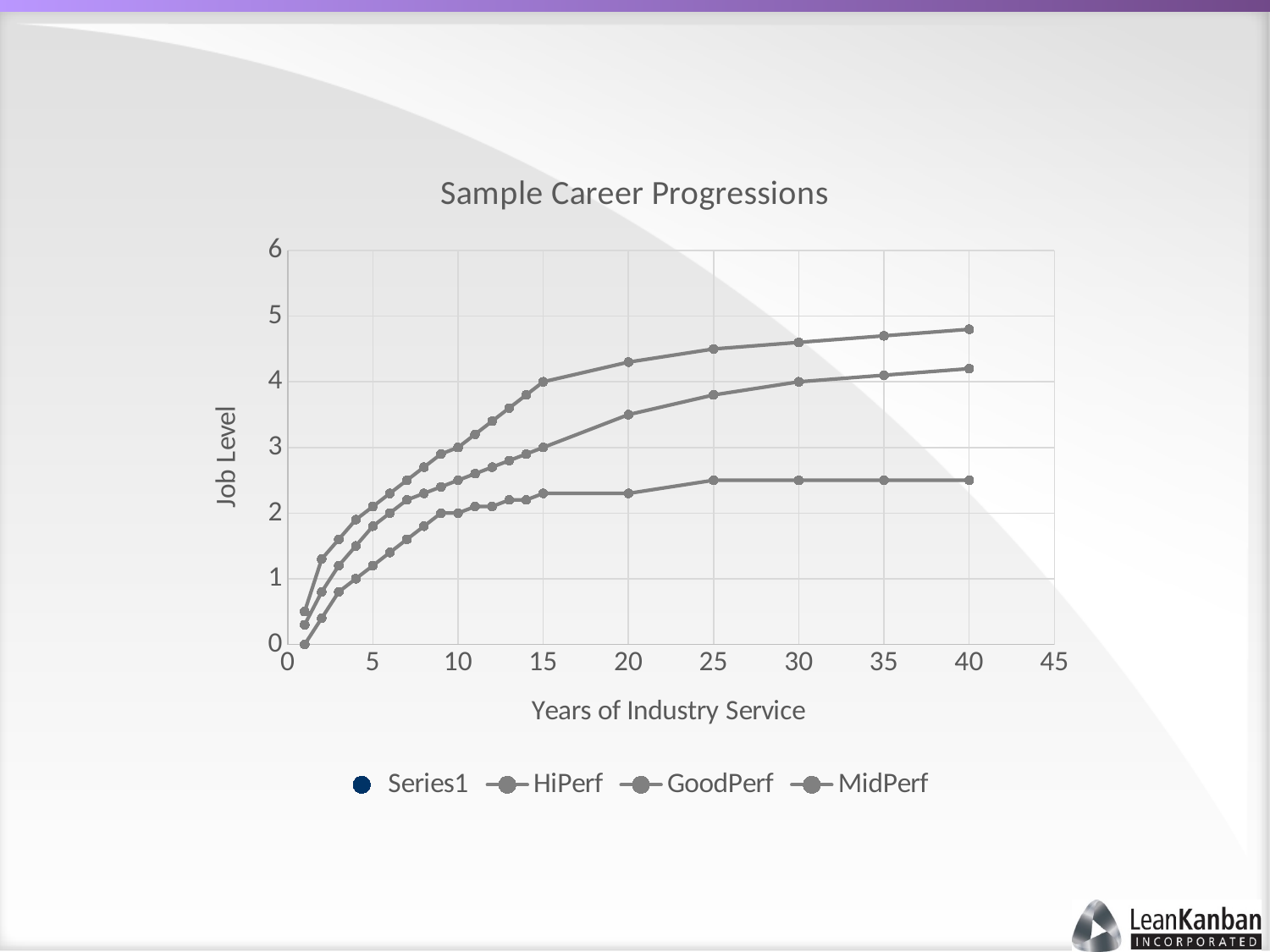
What job level does the lowest line reach at 10 years of industry service? 2 What is the label of the vertical axis? Job Level How many entries does the chart's legend list? 4 At 40 years of industry service, which line has the larger job level, the topmost line or the lowest line? the topmost line How many lines are plotted on the chart? 3 What kind of chart is shown on the slide? line chart What job level does the topmost line reach at 15 years of industry service? 4 Do the plotted job levels rise or fall as years of industry service increase? rise Is the value of the topmost line at 40 years greater or less than 4? greater Is the value of the lowest line at 40 years greater or less than 3? less What is the title of the chart? Sample Career Progressions What job level does the middle line reach at 30 years of industry service? 4